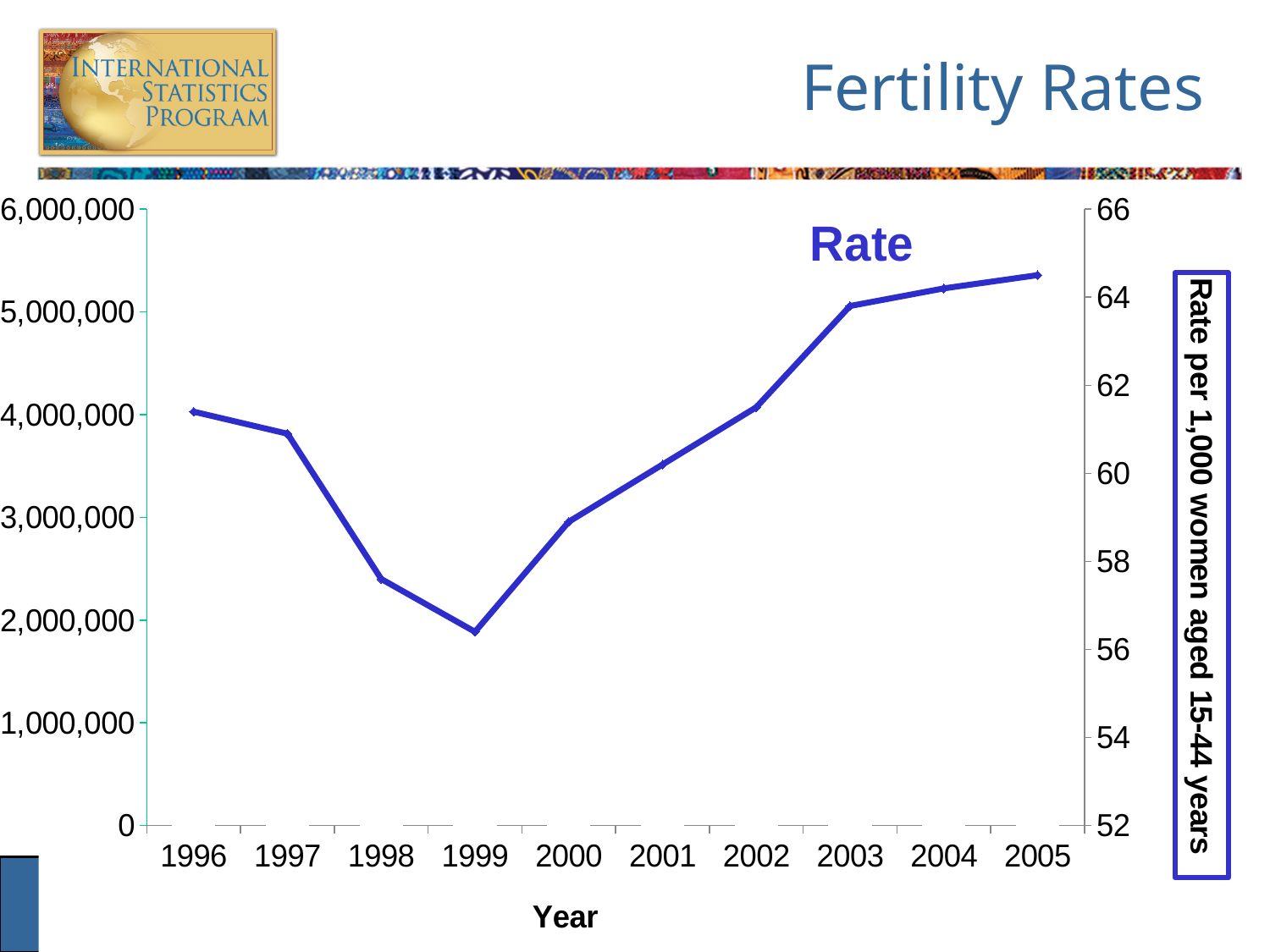
Is the rate for 1996 greater or less than 60? greater Is the rate for 2003 greater or less than 62? greater Which year has the higher rate, 1996 or 1997? 1996 Is the rate for 1998 greater or less than 58? less What kind of chart is shown on the slide? line chart In which year is the fertility rate lowest? 1999 What is the title of the x axis? Year In which year is the fertility rate highest? 2005 Does the rate rise or fall from 1999 to 2005? rise How many years are plotted along the x axis? 10 What is the title of the right-hand y axis? Rate per 1,000 women aged 15-44 years